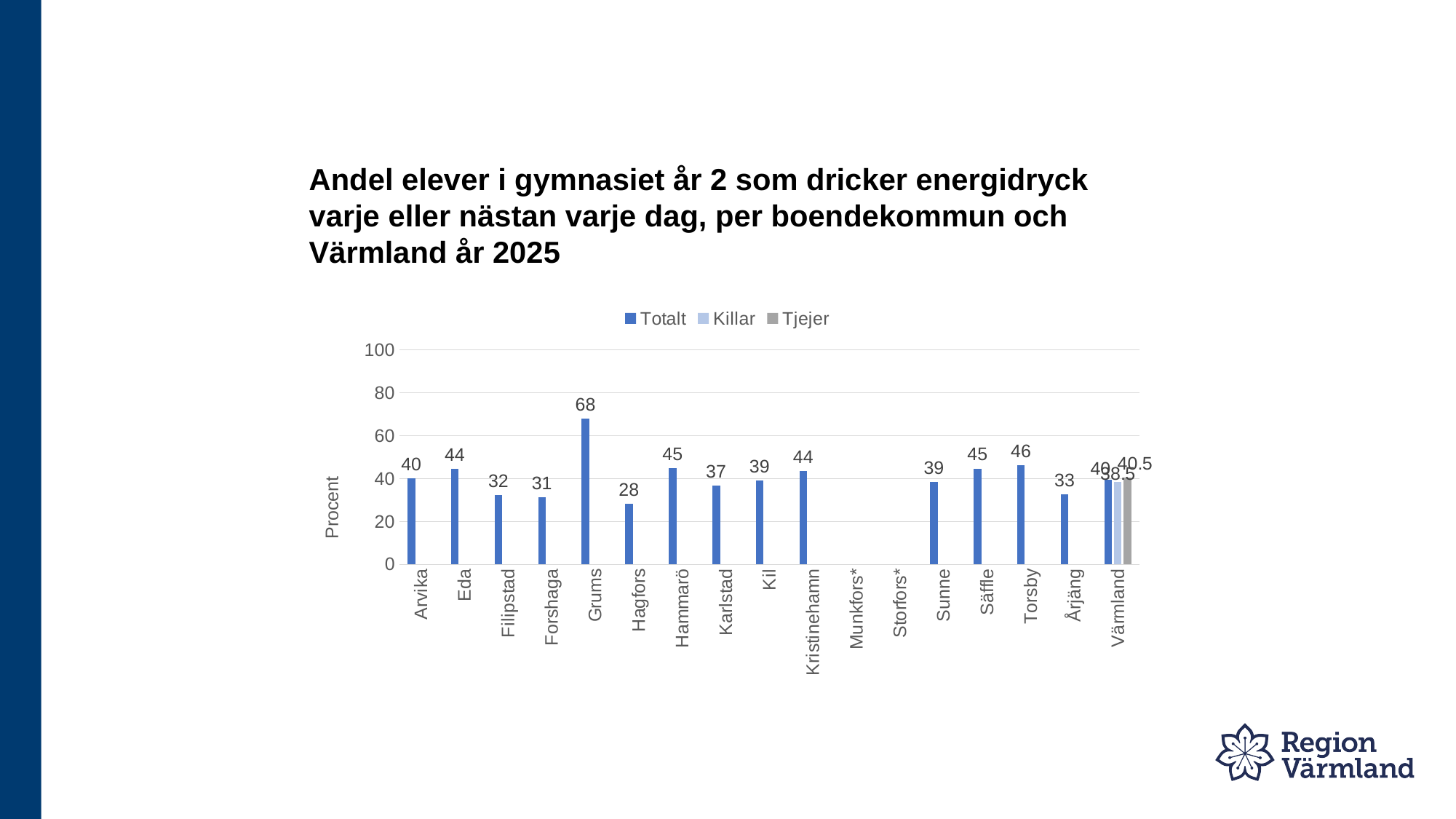
What is the Totalt value for Grums? 68 What is the label on the y axis? Procent How many series does the legend list? 3 What kind of chart is shown on the slide? Bar chart Which has a higher Totalt value, Eda or Filipstad? Eda How many categories are shown on the x axis? 17 What is the Killar value for Värmland? 38.5 What is the Tjejer value for Värmland? 40.5 Which municipality has the highest Totalt value? Grums What is the difference between the Totalt values for Grums and Hagfors? 40 Among the municipalities with a plotted bar, which has the lowest Totalt value? Hagfors What is the difference between the Totalt values for Torsby and Årjäng? 13